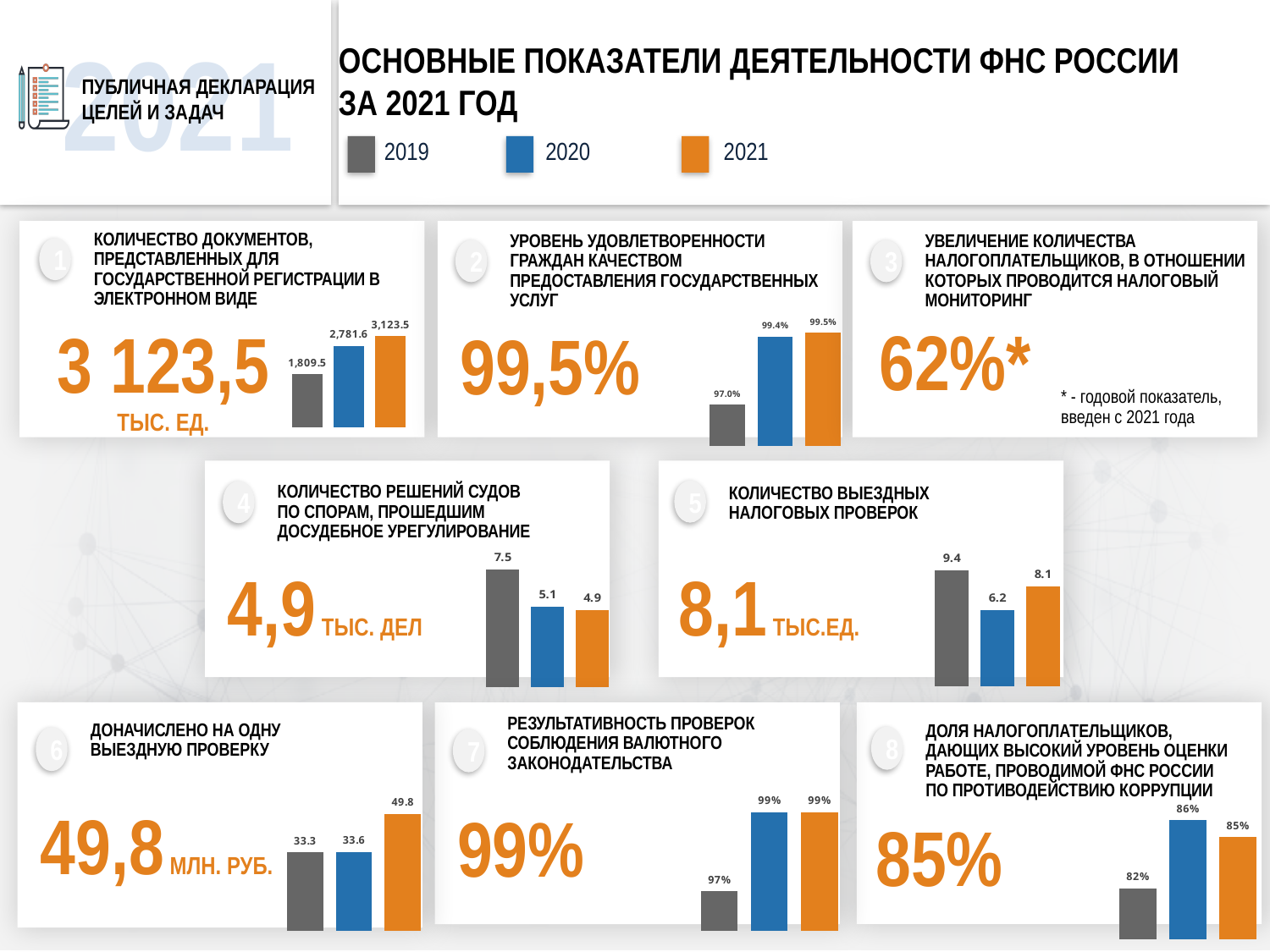
How many years does the shared legend at the top of the slide list? 3 In the chart for panel 2 (citizen satisfaction with the quality of public services), what is the value for 2020? 99.4% In the chart for panel 1 (number of documents submitted for state registration in electronic form), what is the value for 2021? 3,123.5 In the chart for panel 8 (share of taxpayers rating the FNS anti-corruption work highly), what is the value for 2020? 86% In the chart for panel 4 (number of court decisions on disputes that went through pre-trial settlement), which year has the highest value? 2019 In the chart for panel 5 (number of field tax audits), which year has the lowest value? 2020 In the chart for panel 7 (effectiveness of currency legislation compliance audits), what is the value for 2019? 97% In the chart for panel 1 (number of documents submitted for state registration in electronic form), what is the value for 2019? 1,809.5 In the chart for panel 5 (number of field tax audits), what is the difference between the 2019 value and the 2021 value? 1.3 In the chart for panel 6 (additional charges per field audit), which is larger: the value for 2020 or the value for 2021? 2021 What type of chart is used in panel 4 (number of court decisions on disputes that went through pre-trial settlement)? Bar chart In the chart for panel 6 (additional charges per field audit), what is the difference between the 2021 value and the 2019 value? 16.5